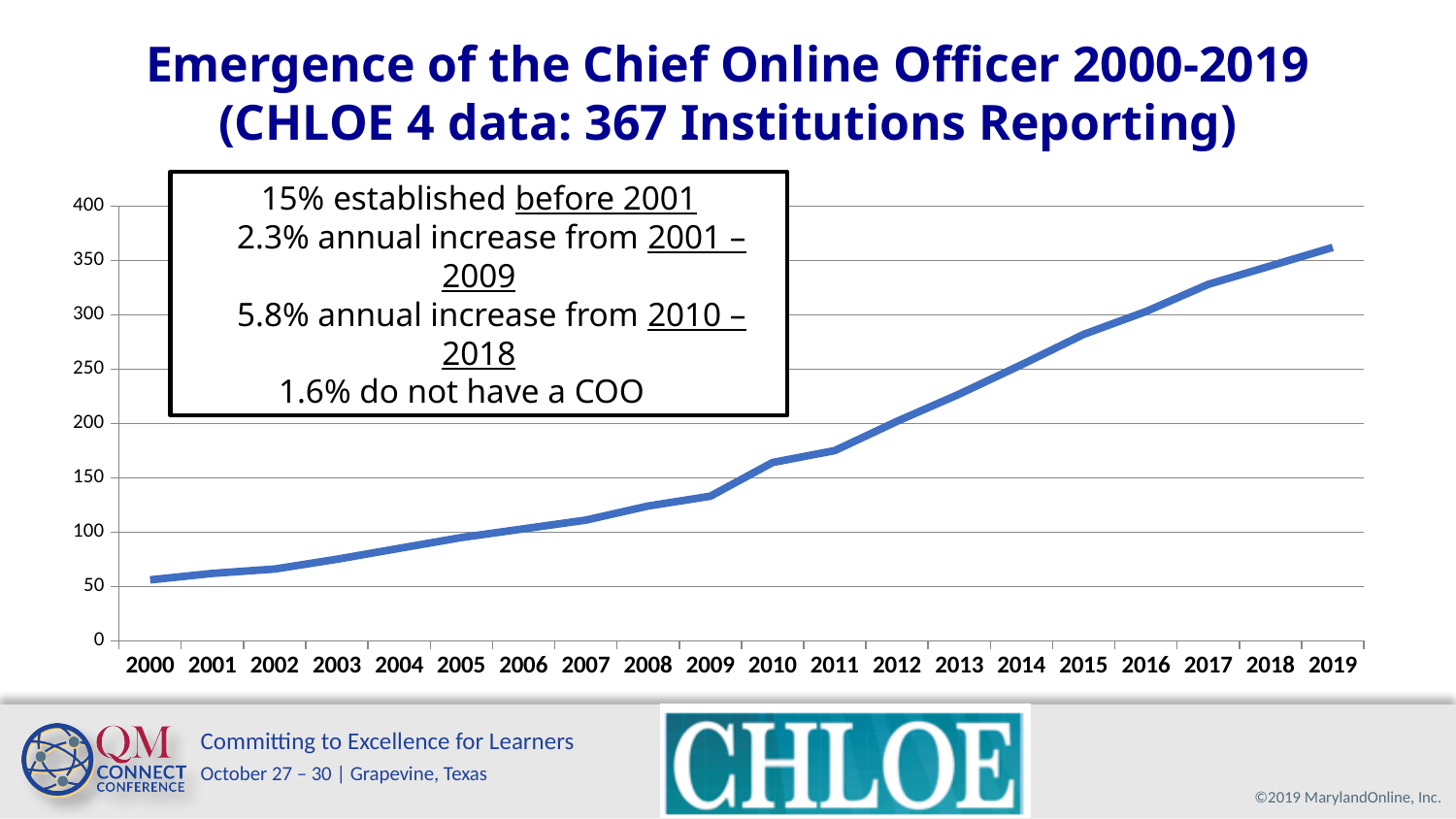
Is the value for 2019 greater or less than 350? greater Which year has the highest value on the chart? 2019 What is the title of the chart on the slide? Emergence of the Chief Online Officer 2000-2019 (CHLOE 4 data: 367 Institutions Reporting) Which year has the larger value, 2009 or 2010? 2010 Is the value for 2013 greater or less than 250? less How many years are plotted along the x axis of the chart? 20 What kind of chart is shown on the slide? line chart Is the value for 2000 greater or less than 100? less Which year has the lowest value on the chart? 2000 Do the values rise or fall from 2000 to 2019? rise